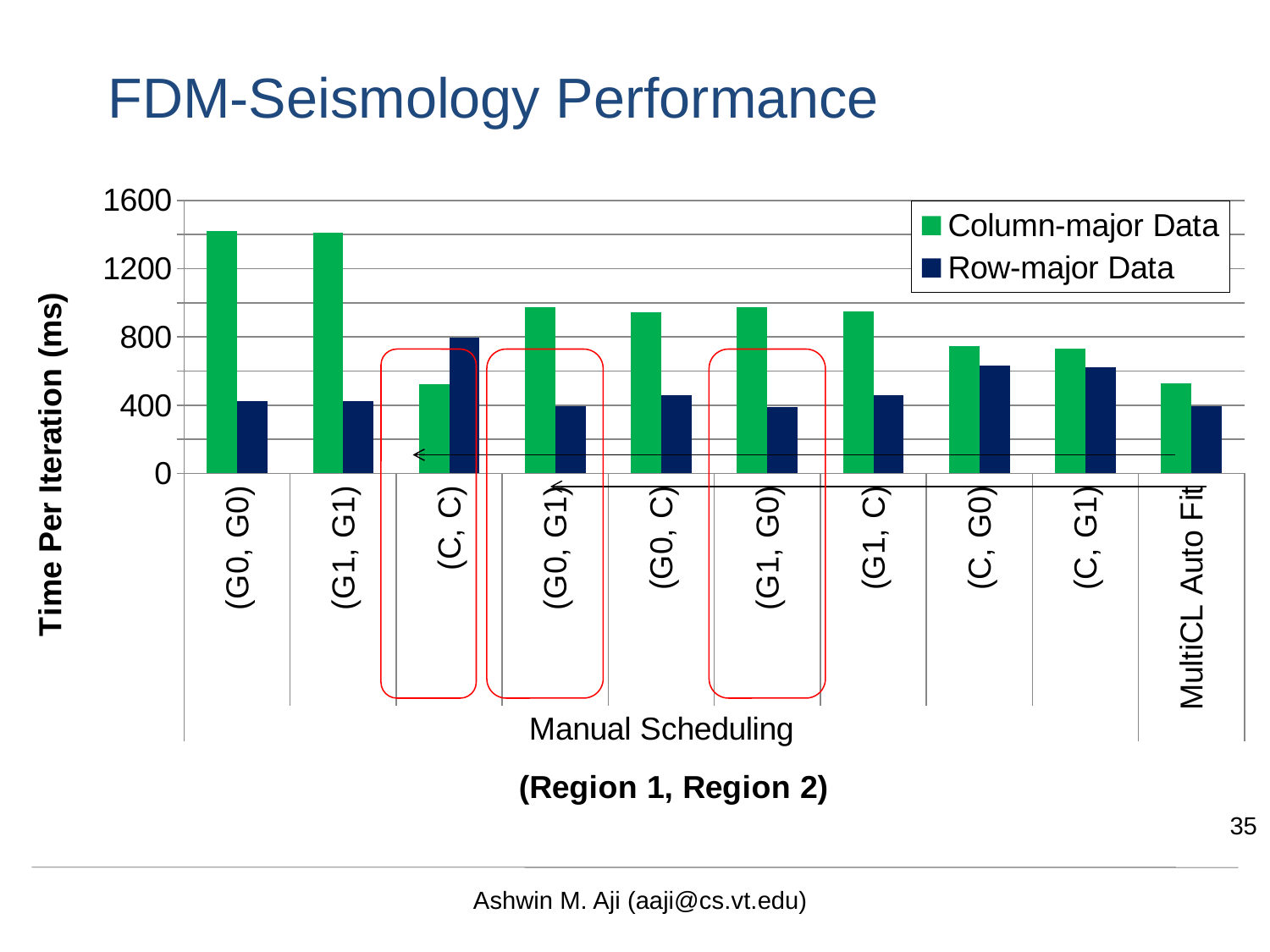
For (G0, G0), which is larger: the Column-major Data value or the Row-major Data value? Column-major Data Which category has the highest Row-major Data value? (C, C) What is the title of the y axis? Time Per Iteration (ms) How many categories are shown along the x axis? 10 Is the Column-major Data value for (C, C) greater or less than 800? less Is the Column-major Data value for MultiCL Auto Fit greater or less than 400? greater For (C, C), which is larger: the Column-major Data value or the Row-major Data value? Row-major Data Is the Column-major Data value for (G0, G0) greater or less than 1200? greater How many series does the legend list? 2 What type of chart is shown on the slide? bar chart